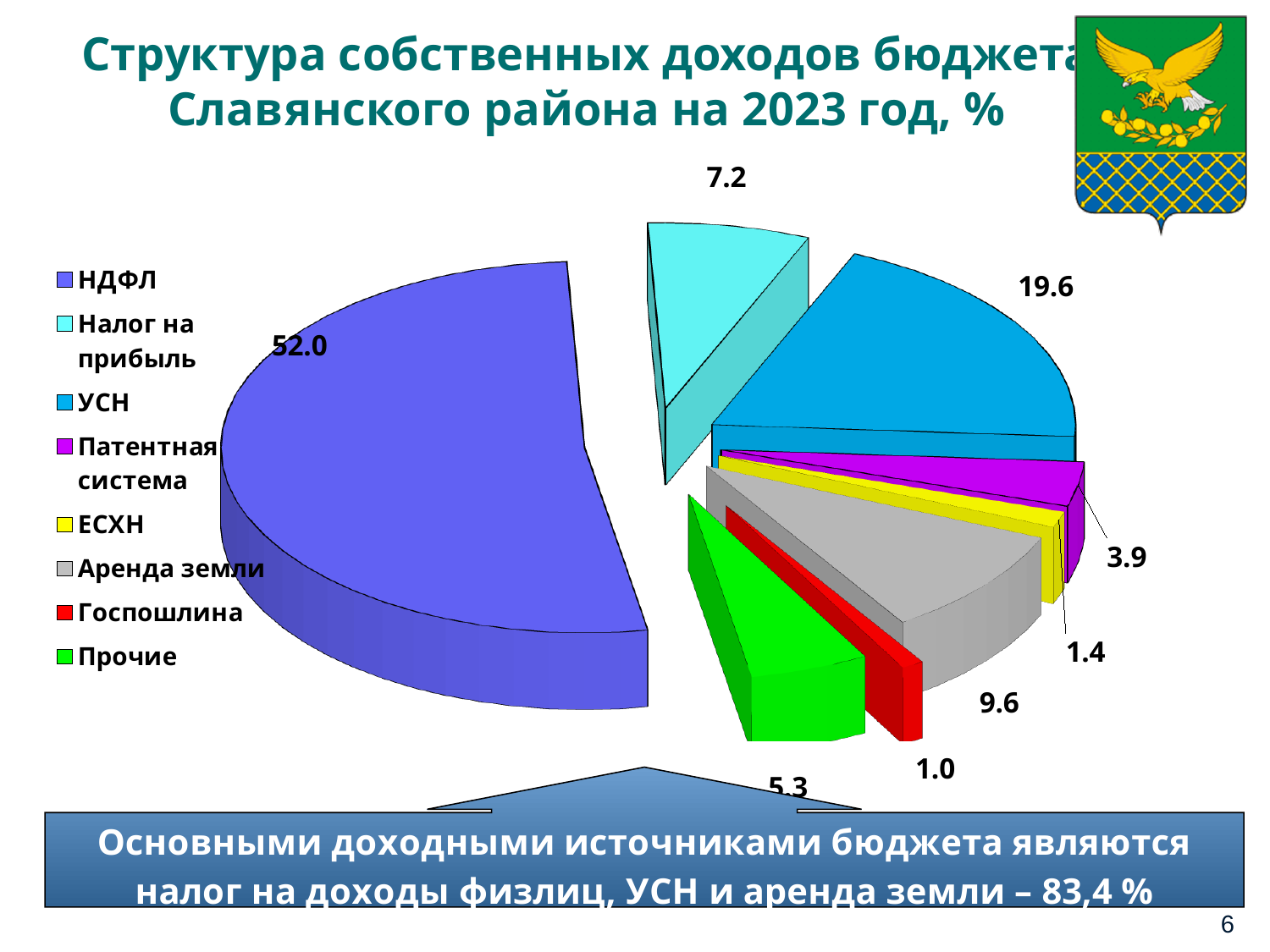
What is the value for УСН? 19.6 Which is larger, Патентная система or ЕСХН? Патентная система What colour is the slice for Прочие? green Which category has the largest share of the pie? НДФЛ What is the value for Аренда земли? 9.6 Which category has the smallest share of the pie? Госпошлина What type of chart is shown on the slide? pie chart What is the value for Госпошлина? 1.0 What is the value for Налог на прибыль? 7.2 How many categories does the legend list? 8 What is the difference between the values for УСН and Аренда земли? 10.0 What is the value for НДФЛ? 52.0